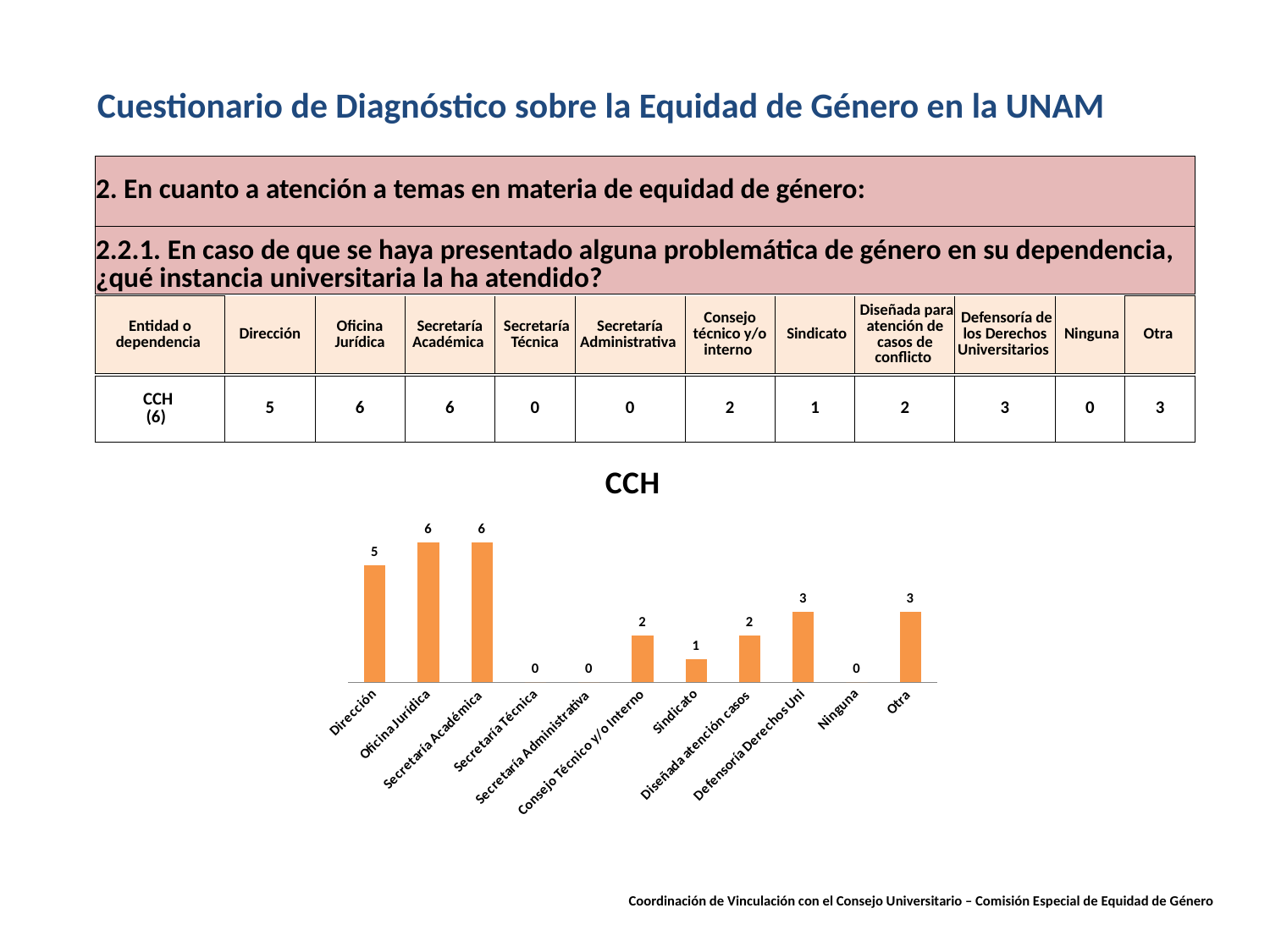
What is the value for Defensoría Derechos Uni in the CCH chart? 3 What is the value for Consejo Técnico y/o Interno in the CCH chart? 2 Which is larger in the CCH chart, Otra or Diseñada atención casos? Otra How many categories are shown on the x axis of the CCH chart? 11 What kind of chart is shown on the slide? Bar chart Which categories have a value of 0 in the CCH chart? Secretaría Técnica, Secretaría Administrativa and Ninguna What is the value for Sindicato in the CCH chart? 1 What is the difference between the values for Oficina Jurídica and Dirección in the CCH chart? 1 Which categories have the highest value in the CCH chart? Oficina Jurídica and Secretaría Académica What is the value for Dirección in the CCH chart? 5 What is the difference between the values for Defensoría Derechos Uni and Sindicato in the CCH chart? 2 What is the title of the chart on the slide? CCH